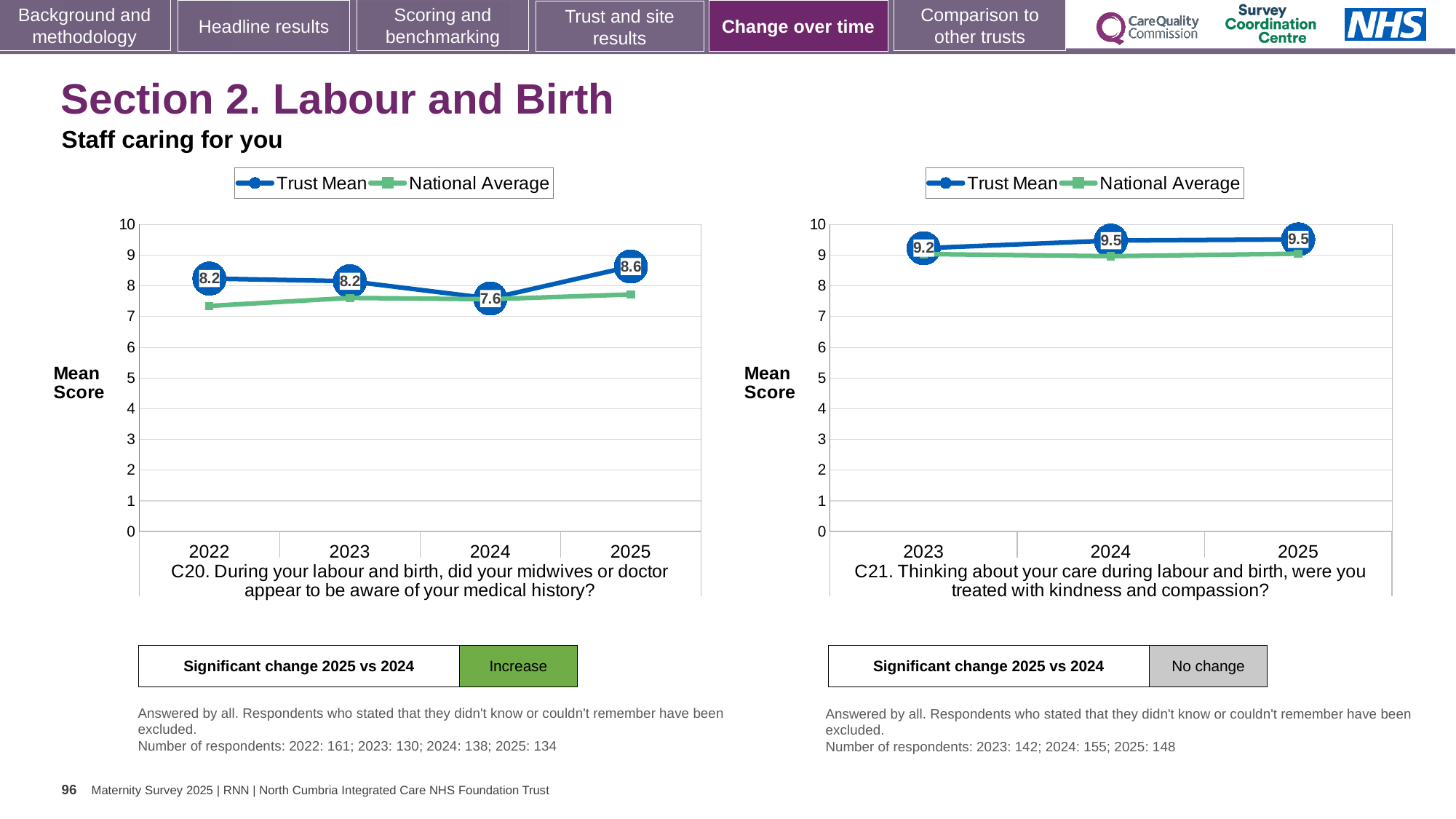
In the C20 chart (left), what is the Trust Mean for 2024? 7.6 How many years are plotted on the x axis of the C21 chart (right)? 3 How many series does the legend of the C20 chart (left) list? 2 In the C20 chart (left), is the Trust Mean for 2024 greater or less than 8? less In the C20 chart (left), what is the Trust Mean for 2025? 8.6 In the C21 chart (right), what is the difference between the Trust Mean in 2024 and in 2023? 0.3 In the C21 chart (right), is the National Average for 2025 greater or less than 8? greater In the C20 chart (left), which year has the highest Trust Mean? 2025 In the C20 chart (left), what is the difference between the Trust Mean in 2025 and in 2024? 1.0 In the C21 chart (right), what is the Trust Mean for 2023? 9.2 In the C20 chart (left), which year has the lowest Trust Mean? 2024 What type of chart is the C20 chart (left)? Line chart